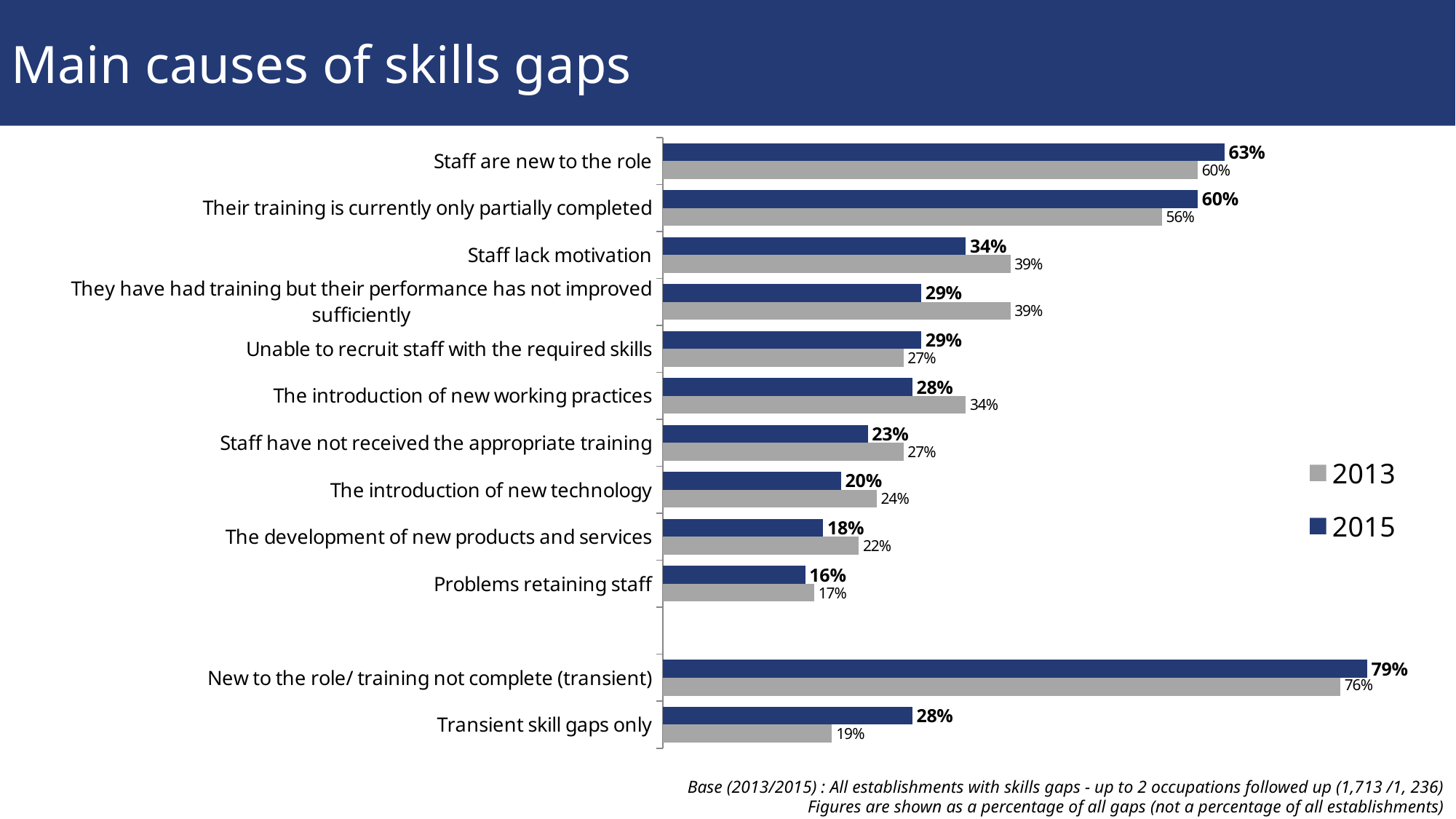
Which category has the highest 2015 value? New to the role/ training not complete (transient) Which colour represents the 2013 series in the chart? Grey What is the difference between the 2013 and 2015 values for 'Staff lack motivation'? 5% What kind of chart is shown on the slide? Bar chart For 'Unable to recruit staff with the required skills', which year has the larger value, 2013 or 2015? 2015 What is the 2013 value for 'The introduction of new technology'? 24% Which category has the lowest 2013 value? Problems retaining staff How many series does the legend list? 2 What is the 2013 value for 'Staff lack motivation'? 39% What is the 2015 value for 'Staff are new to the role'? 63% What is the 2015 value for 'Transient skill gaps only'? 28% What is the difference between the 2015 and 2013 values for 'Transient skill gaps only'? 9%